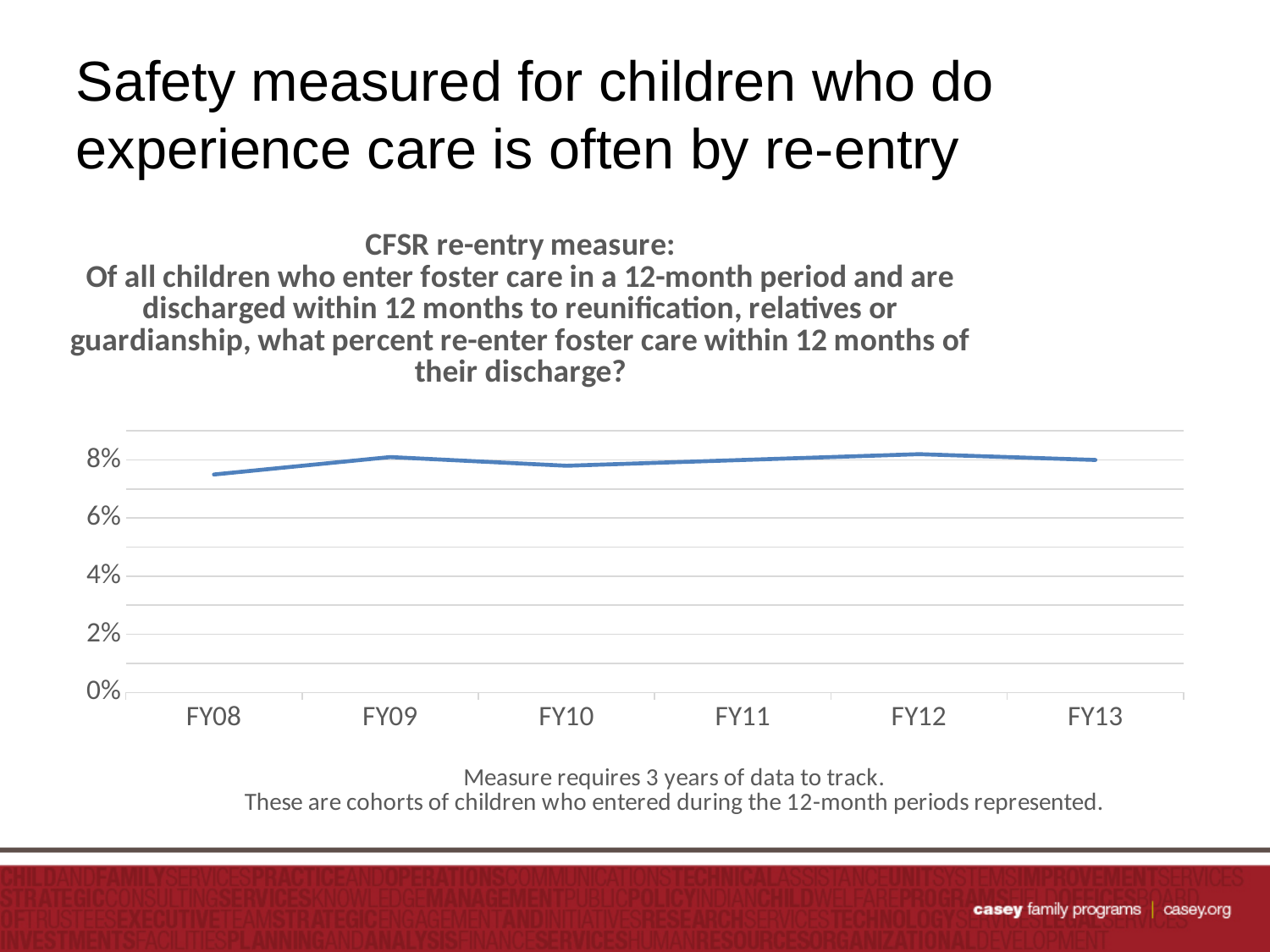
Which is larger, the value for FY08 or the value for FY12? FY12 Does the re-entry percentage rise or fall from FY08 to FY13 overall? rise Which is larger, the value for FY08 or the value for FY09? FY09 How many fiscal years are plotted on the x axis? 6 Is the value for FY13 greater or less than 4%? greater What is the first fiscal year shown on the x axis? FY08 What kind of chart is shown on the slide? line chart Which fiscal year has the lowest re-entry percentage? FY08 What is the highest value labelled on the y axis? 8% Is the value for FY08 greater or less than 8%? less Is the value for FY11 greater or less than 6%? greater